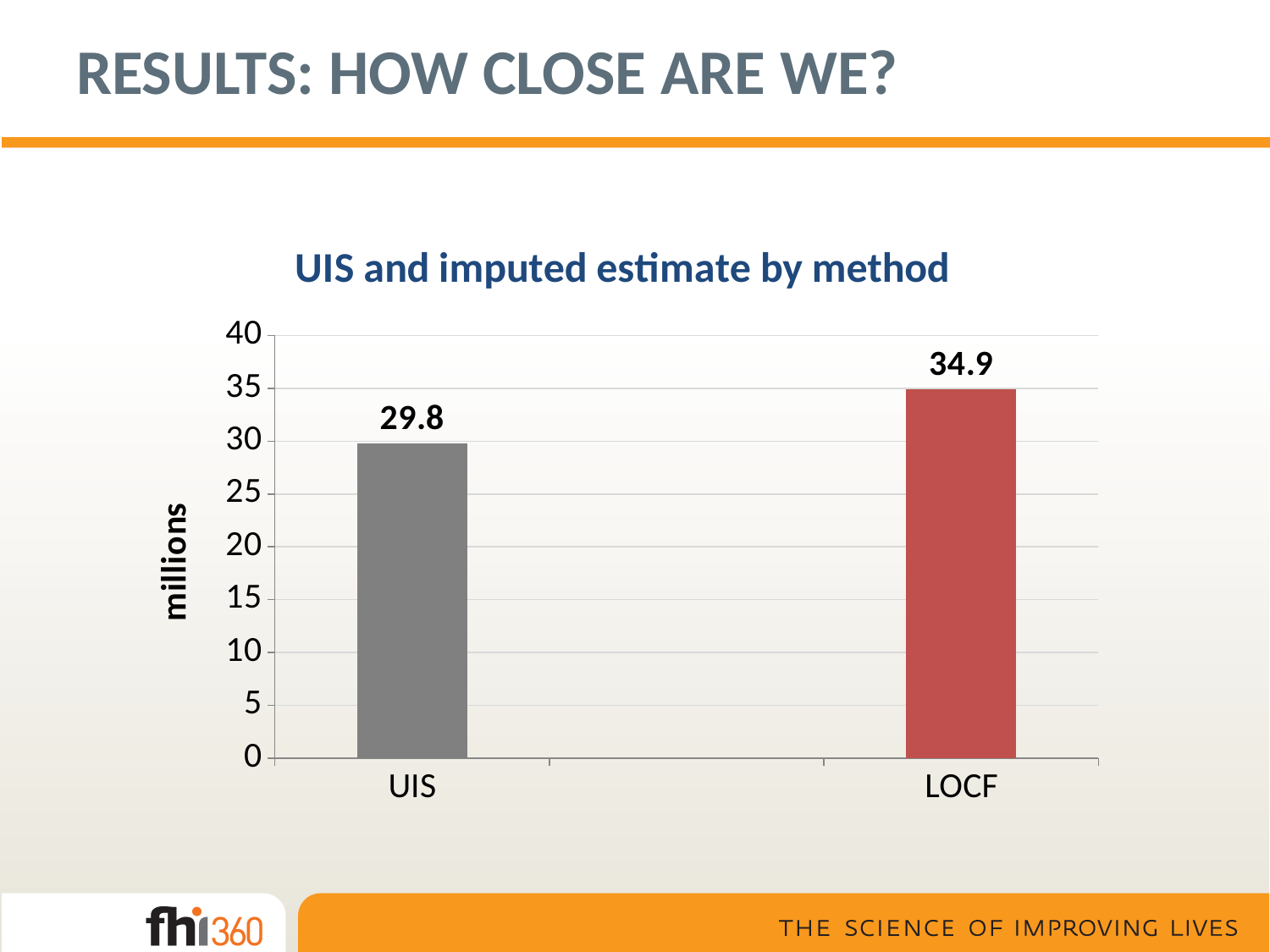
What is the label on the vertical axis? millions Which is larger, the value for UIS or the value for LOCF? LOCF How many categories are shown on the x axis? 2 What is the difference between the LOCF and UIS values? 5.1 Is the value for UIS greater or less than 30? less Is the value for LOCF greater or less than 30? greater Which category has the highest value? LOCF Which category has the lowest value? UIS What is the value for UIS? 29.8 What kind of chart is shown on the slide? bar chart What is the title of the chart? UIS and imputed estimate by method What is the value for LOCF? 34.9